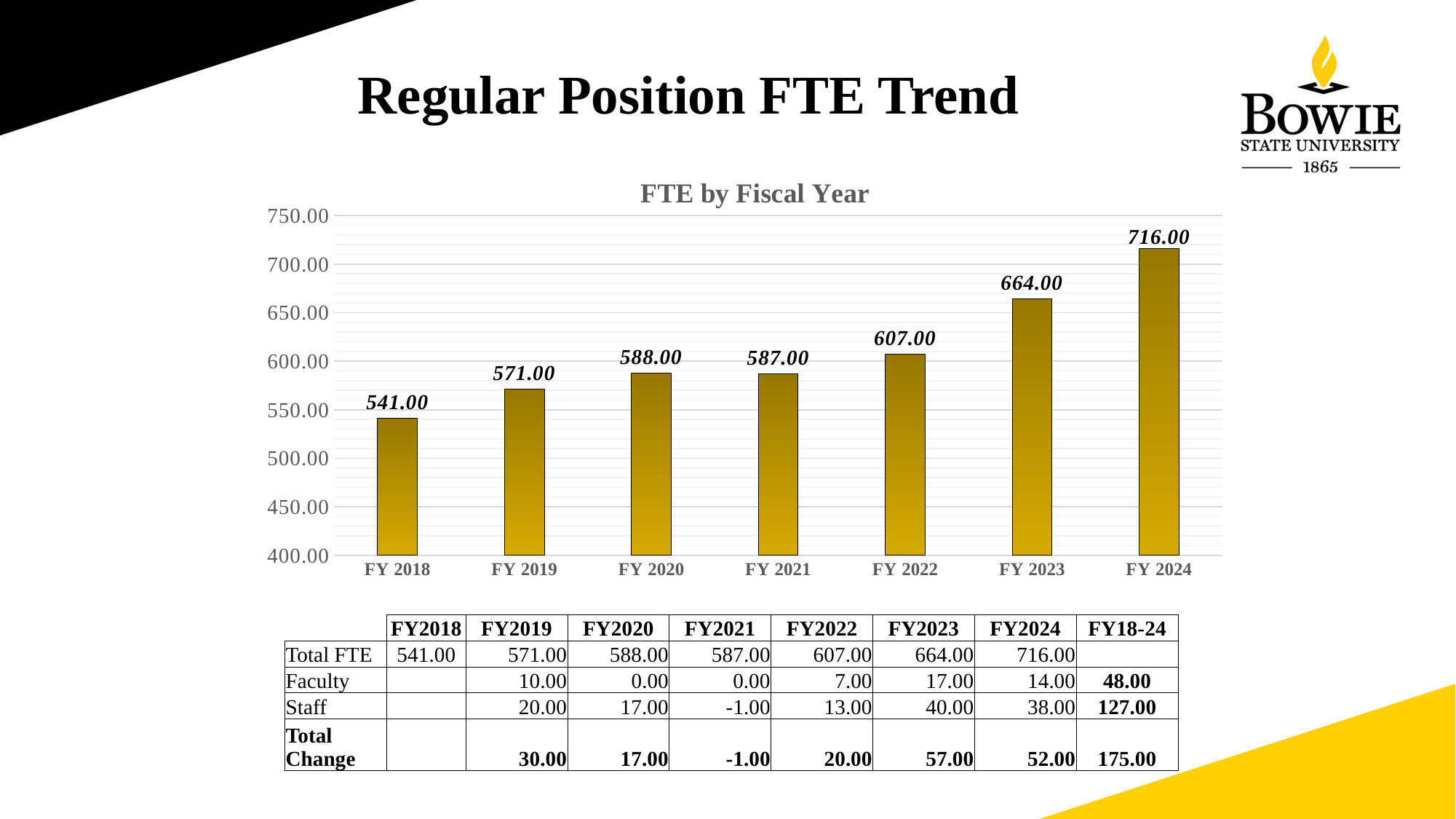
Which has a higher FTE, FY 2020 or FY 2022? FY 2022 Which fiscal year has the highest FTE? FY 2024 How many fiscal years are shown in the chart? 7 What is the title of the chart? FTE by Fiscal Year What is the FTE value for FY 2022? 607.00 What is the difference in FTE between FY 2024 and FY 2018? 175.00 What is the FTE value for FY 2024? 716.00 What is the difference in FTE between FY 2023 and FY 2022? 57.00 What type of chart is shown on the slide? bar chart Which fiscal year has the lowest FTE? FY 2018 What is the FTE value for FY 2018? 541.00 Is the FTE value for FY 2023 greater or less than 650.00? greater